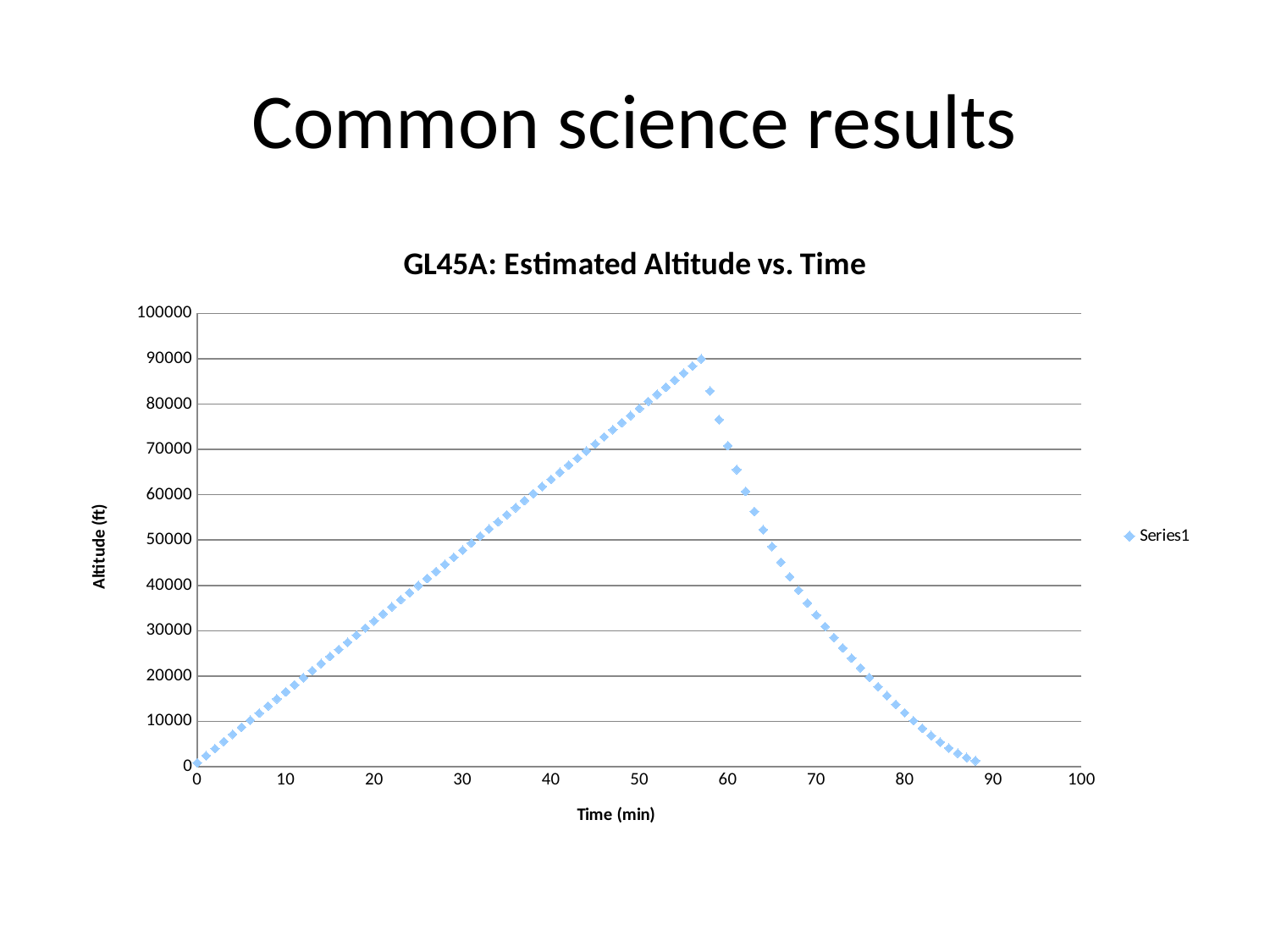
What is the title of the chart? GL45A: Estimated Altitude vs. Time Is the altitude at time 30 min greater or less than 40000? greater What kind of chart is shown on the slide? Scatter chart Between time 60 and time 85 min, does the altitude rise or fall? fall Is the peak altitude reached greater or less than 80000? greater Between time 0 and time 50 min, does the altitude rise or fall? rise Is the altitude at time 20 min greater or less than 20000? greater What is the label of the vertical axis? Altitude (ft) How many series does the legend list? 1